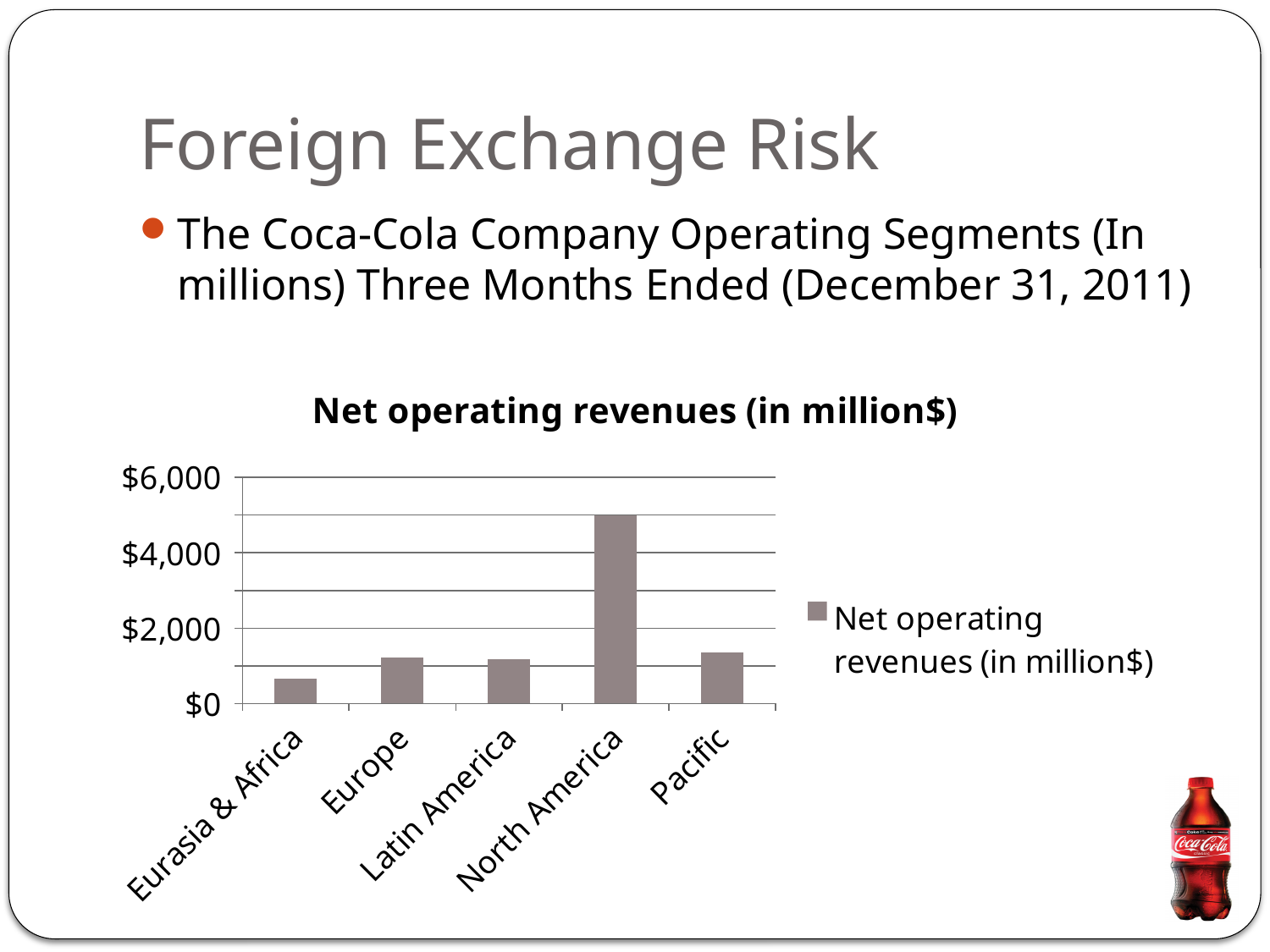
Which segment has the highest net operating revenues in the chart? North America Is the value for Pacific greater or less than $2,000? less Which has larger net operating revenues, Pacific or Eurasia & Africa? Pacific What is the title of the chart? Net operating revenues (in million$) What type of chart is shown on the slide? bar chart Is the value for Eurasia & Africa greater or less than $2,000? less What is the name of the series listed in the chart's legend? Net operating revenues (in million$) How many operating segments (categories) are shown on the x axis of the chart? 5 Which segment has the lowest net operating revenues in the chart? Eurasia & Africa Is the value for North America greater or less than $4,000? greater How many series does the chart's legend list? 1 Which has larger net operating revenues, North America or Europe? North America